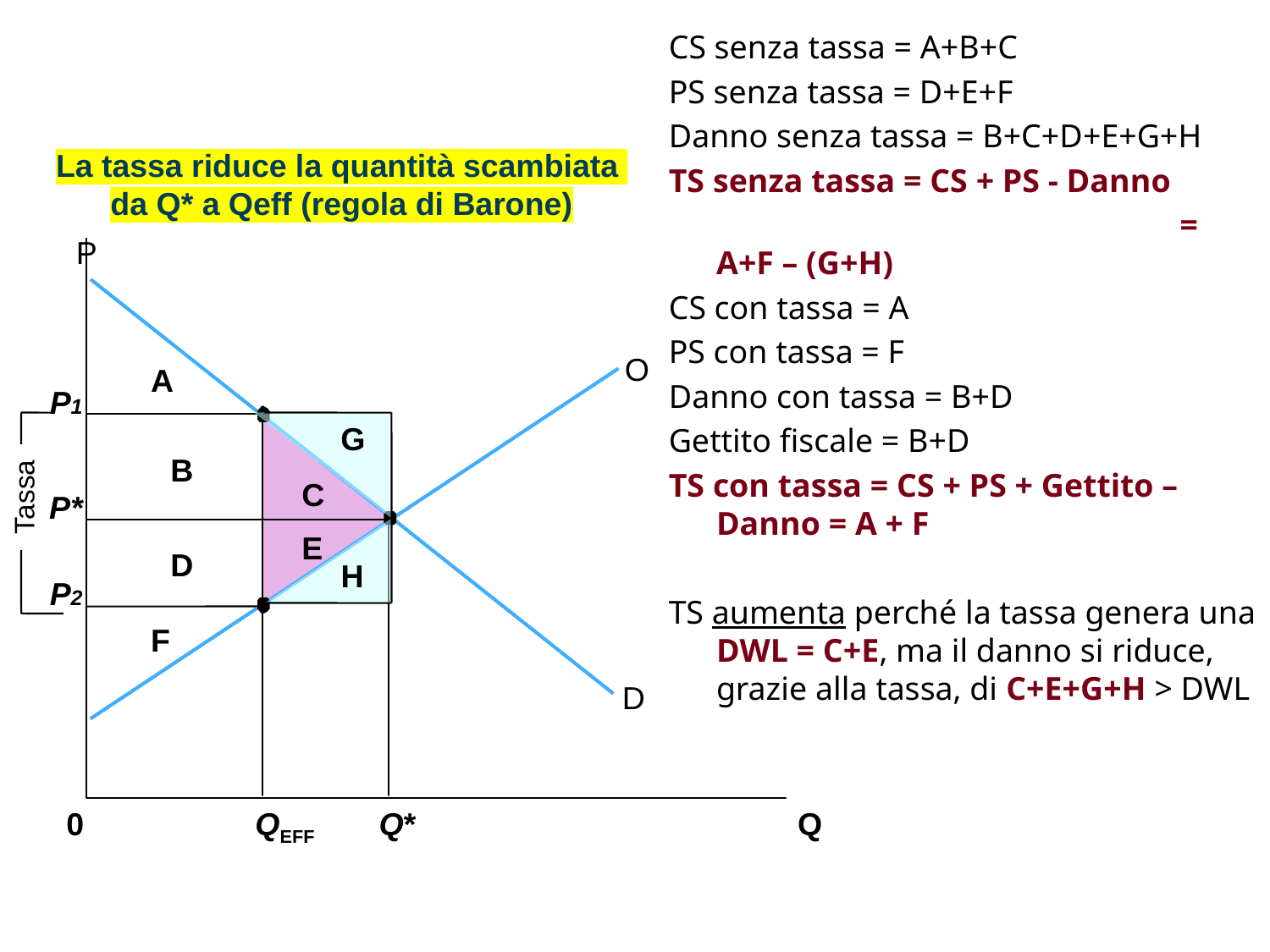
How many quantity levels are labelled on the horizontal axis of the diagram? 2 Does the curve labelled D rise or fall as Q increases? fall What kind of chart is shown on the slide? supply and demand diagram Which lettered regions are shaded in pink/magenta in the diagram? C and E How many lettered regions (A, B, C, ...) are marked in the diagram? 8 How many price levels are labelled on the vertical axis of the diagram? 3 Which is larger, P1 or P2? P1 Which is larger, Q* or QEFF? Q* Does the curve labelled O rise or fall as Q increases? rise What label is on the horizontal axis of the diagram? Q